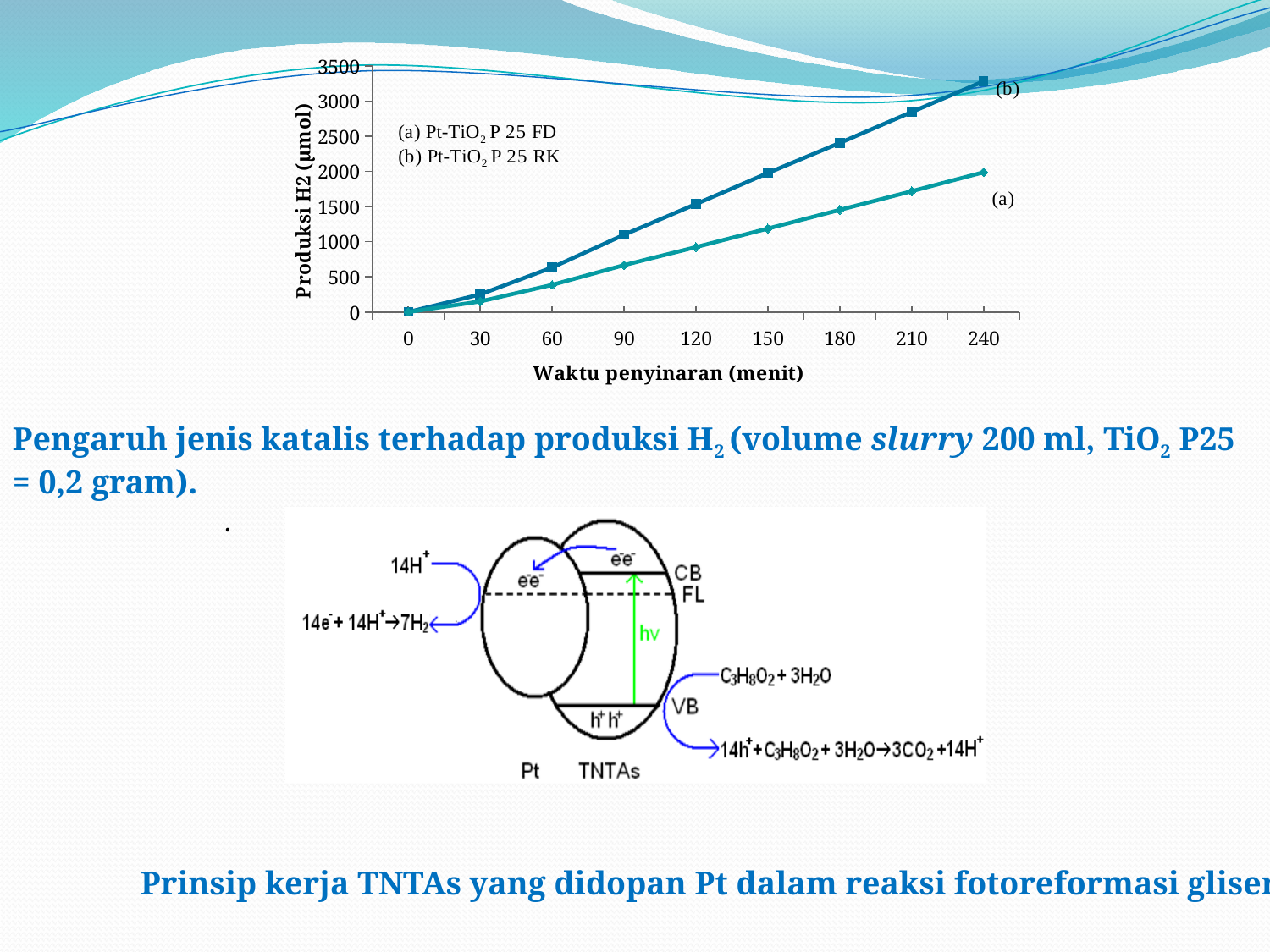
What kind of chart is shown at the top of the slide? line chart Which series has the higher H2 production at 120 minutes, (a) or (b)? (b) Pt-TiO2 P 25 RK What is the title of the y axis of the chart? Produksi H2 (µmol) What is the title of the x axis of the chart? Waktu penyinaran (menit) Which series has the higher H2 production at 240 minutes, (a) Pt-TiO2 P 25 FD or (b) Pt-TiO2 P 25 RK? (b) Pt-TiO2 P 25 RK Is the H2 production for series (a) Pt-TiO2 P 25 FD at 60 minutes greater or less than 500 µmol? less Is the H2 production for series (b) Pt-TiO2 P 25 RK at 240 minutes greater or less than 3000 µmol? greater How many time points are plotted along the x axis for each series? 9 Is the H2 production for series (a) Pt-TiO2 P 25 FD at 240 minutes greater or less than 2500 µmol? less Do the H2 production values for series (b) rise or fall as irradiation time increases? rise How many series does the chart's legend list? 2